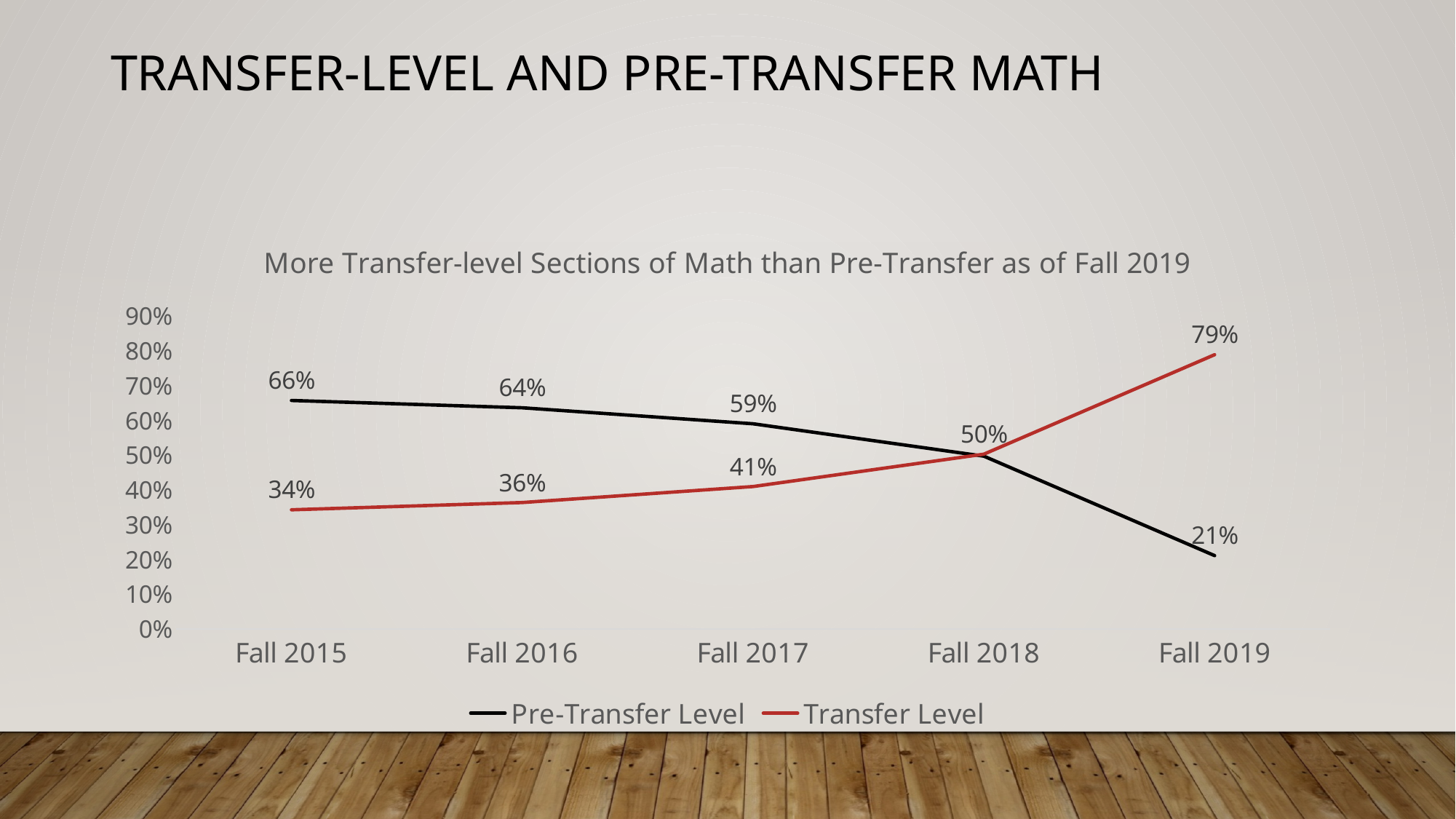
How many periods are shown on the x axis? 5 In which period does the Pre-Transfer Level series reach its lowest value? Fall 2019 Does the Pre-Transfer Level series rise or fall from Fall 2015 to Fall 2019? Fall What is the Transfer Level value for Fall 2017? 41% What is the Transfer Level value for Fall 2019? 79% What kind of chart is shown on the slide? Line chart What is the title of the chart? More Transfer-level Sections of Math than Pre-Transfer as of Fall 2019 Which series has the larger value in Fall 2016, Pre-Transfer Level or Transfer Level? Pre-Transfer Level How many series does the legend list? 2 What is the Pre-Transfer Level value for Fall 2015? 66% What is the difference between the Transfer Level and Pre-Transfer Level values in Fall 2019? 58% In which period does the Transfer Level series reach its highest value? Fall 2019